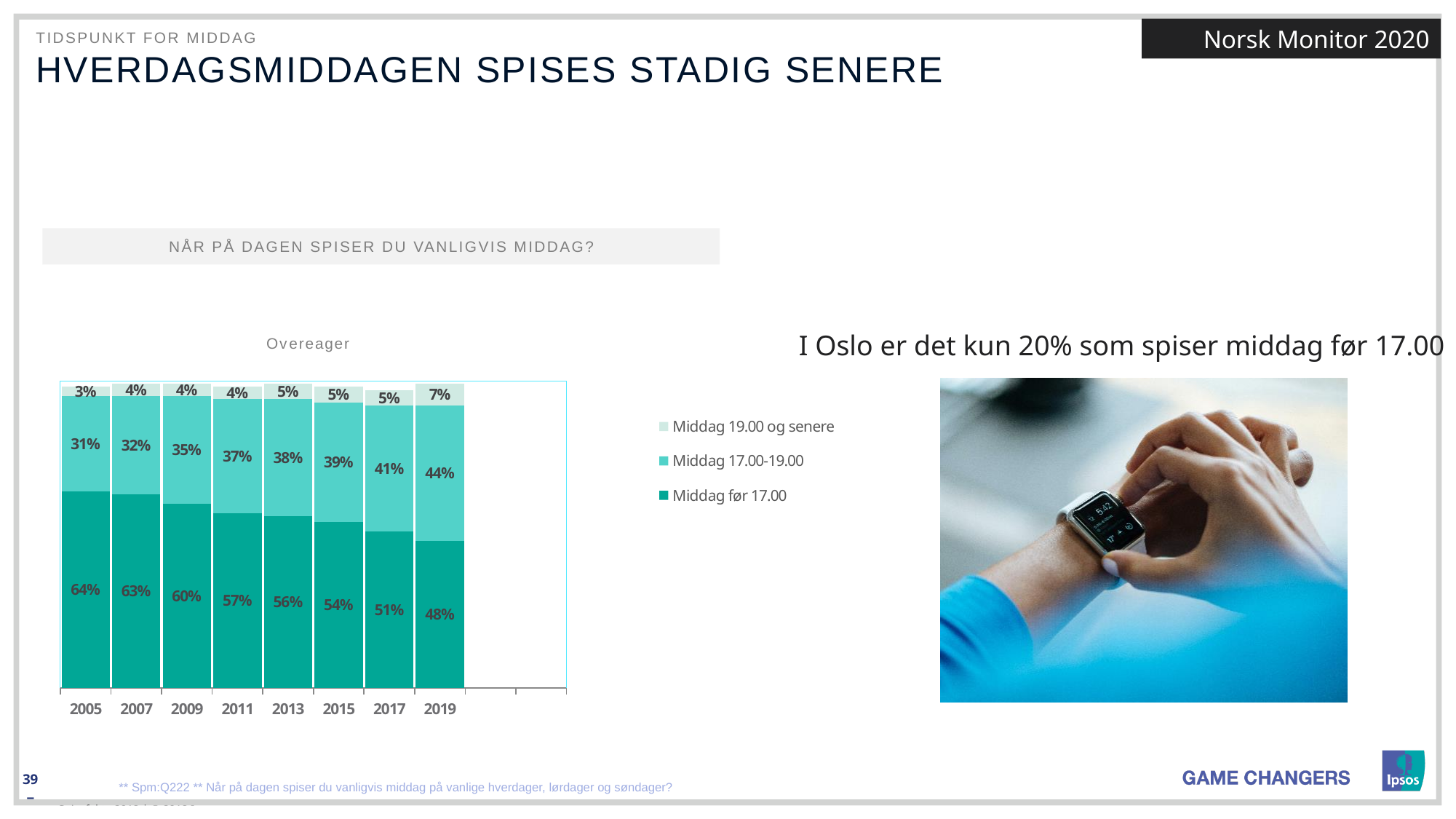
What kind of chart is shown on the slide? Stacked bar chart In which year is the share for Middag før 17.00 lowest? 2019 What percentage ate dinner between 17.00 and 19.00 (Middag 17.00-19.00) in 2019? 44% What percentage ate dinner at 19.00 or later (Middag 19.00 og senere) in 2013? 5% How many series does the legend list? 3 What is the difference in percentage points between Middag før 17.00 in 2005 and in 2019? 16 In which year is the share for Middag 19.00 og senere highest? 2019 What percentage ate dinner before 17.00 (Middag før 17.00) in 2005? 64% How many years are shown on the x axis of the chart? 8 What is the total of the stacked bar for 2009? 99% Which is larger: Middag 17.00-19.00 in 2011 or Middag 17.00-19.00 in 2017? 2017 Does the share for Middag før 17.00 rise or fall from 2005 to 2019? Fall